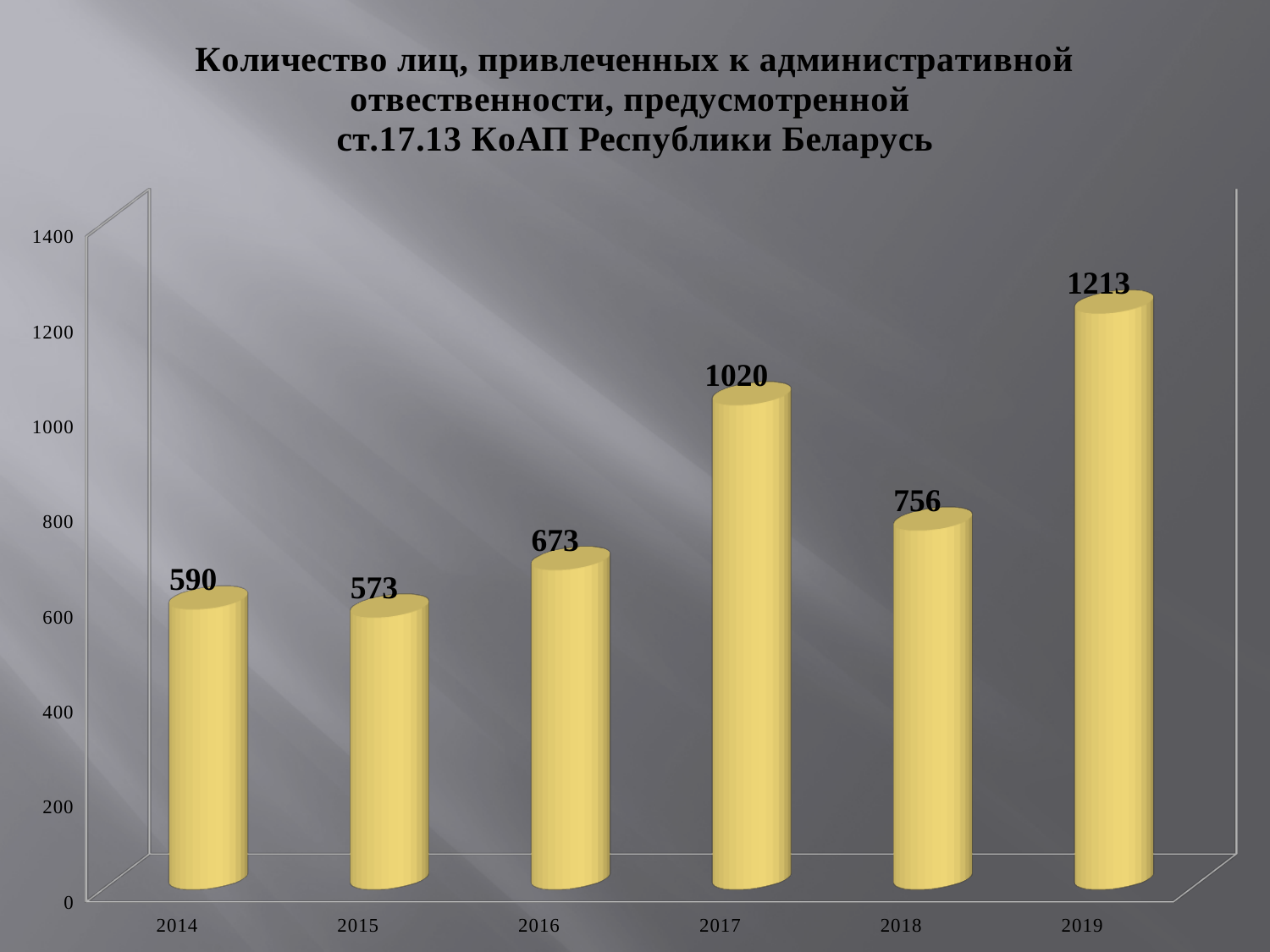
Does the value rise or fall from 2017 to 2018? fall Which is larger, the value for 2018 or the value for 2016? 2018 Is the value for 2017 greater or less than 1000? greater Which year has the lowest value? 2015 What is the value for 2018? 756 What is the difference between the values for 2019 and 2017? 193 What is the difference between the values for 2016 and 2015? 100 What is the value for 2014? 590 What kind of chart is shown on the slide? bar chart What is the value for 2017? 1020 Which year has the highest value? 2019 How many years are shown on the x axis? 6